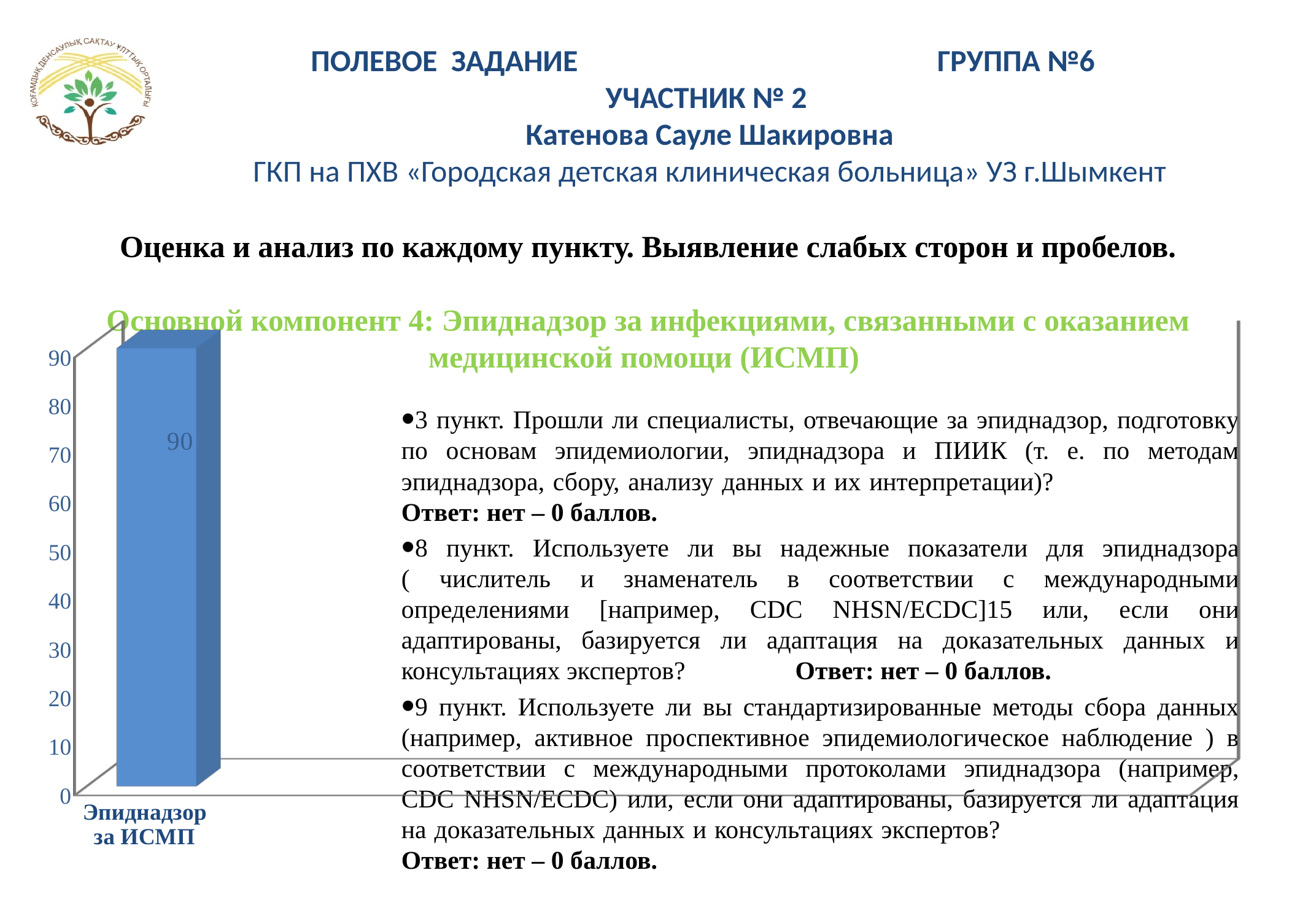
How many bars does the chart contain? 1 What is the label of the category on the x axis of the chart? Эпиднадзор за ИСМП What is the highest tick value shown on the vertical axis of the chart? 90 What kind of chart is shown on the left of the slide? bar chart Is the value for "Эпиднадзор за ИСМП" greater or less than 50? greater What is the value shown for "Эпиднадзор за ИСМП" in the bar chart? 90